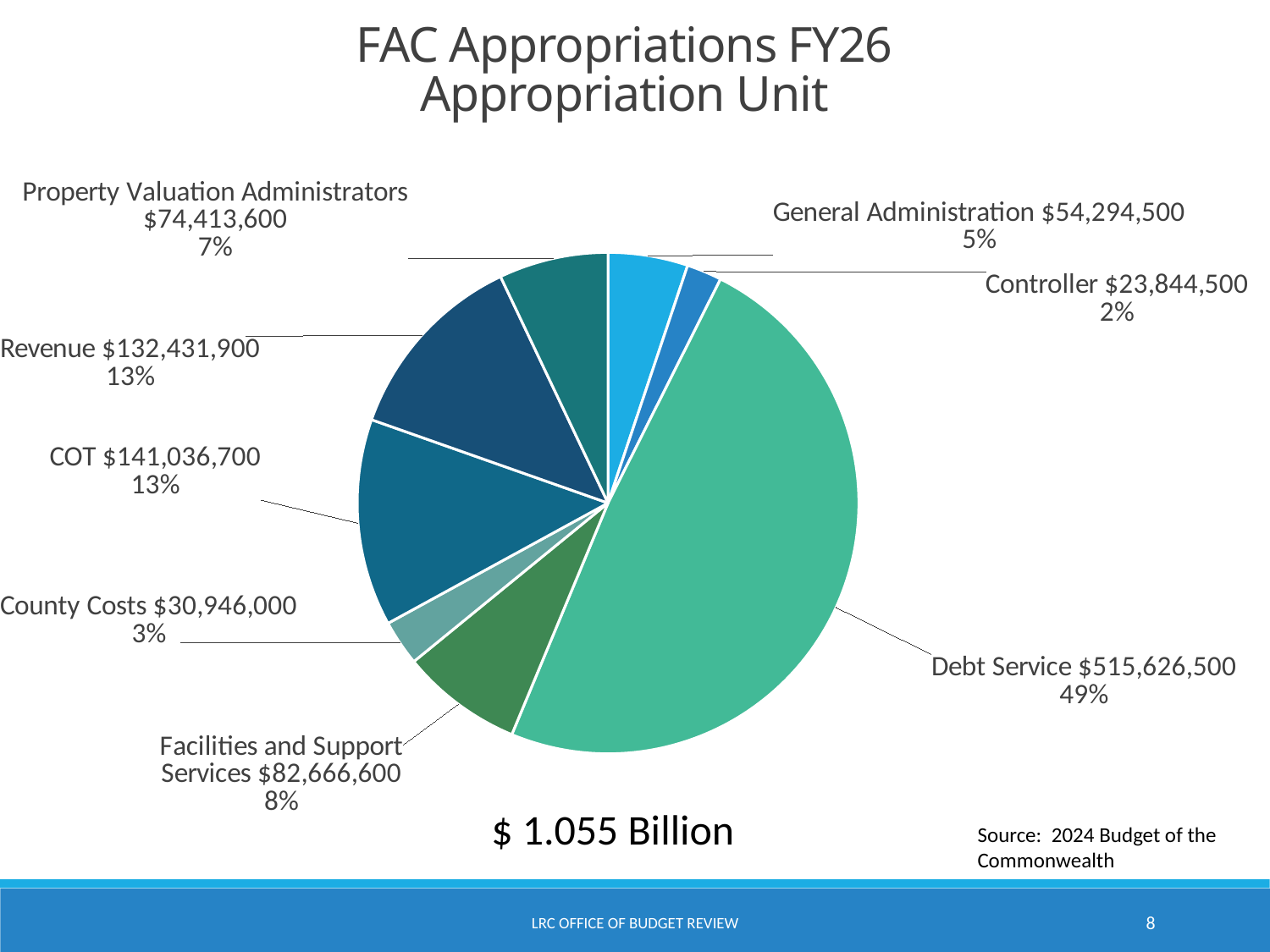
What total amount is shown below the pie chart? $ 1.055 Billion Which appropriation unit has the smallest share of the pie? Controller Which appropriation unit has the largest share of the pie? Debt Service What is the appropriation amount for Controller? $23,844,500 What is the appropriation amount for COT? $141,036,700 What kind of chart is shown on the slide? Pie chart What is the difference between the appropriation for General Administration and the appropriation for County Costs? $23,348,500 What is the appropriation amount for Debt Service? $515,626,500 What percentage share of the pie does Property Valuation Administrators have? 7% What percentage share of the pie does Facilities and Support Services have? 8% Which is larger, the appropriation for Revenue or the appropriation for COT? COT How many appropriation units are shown in the pie chart? 8